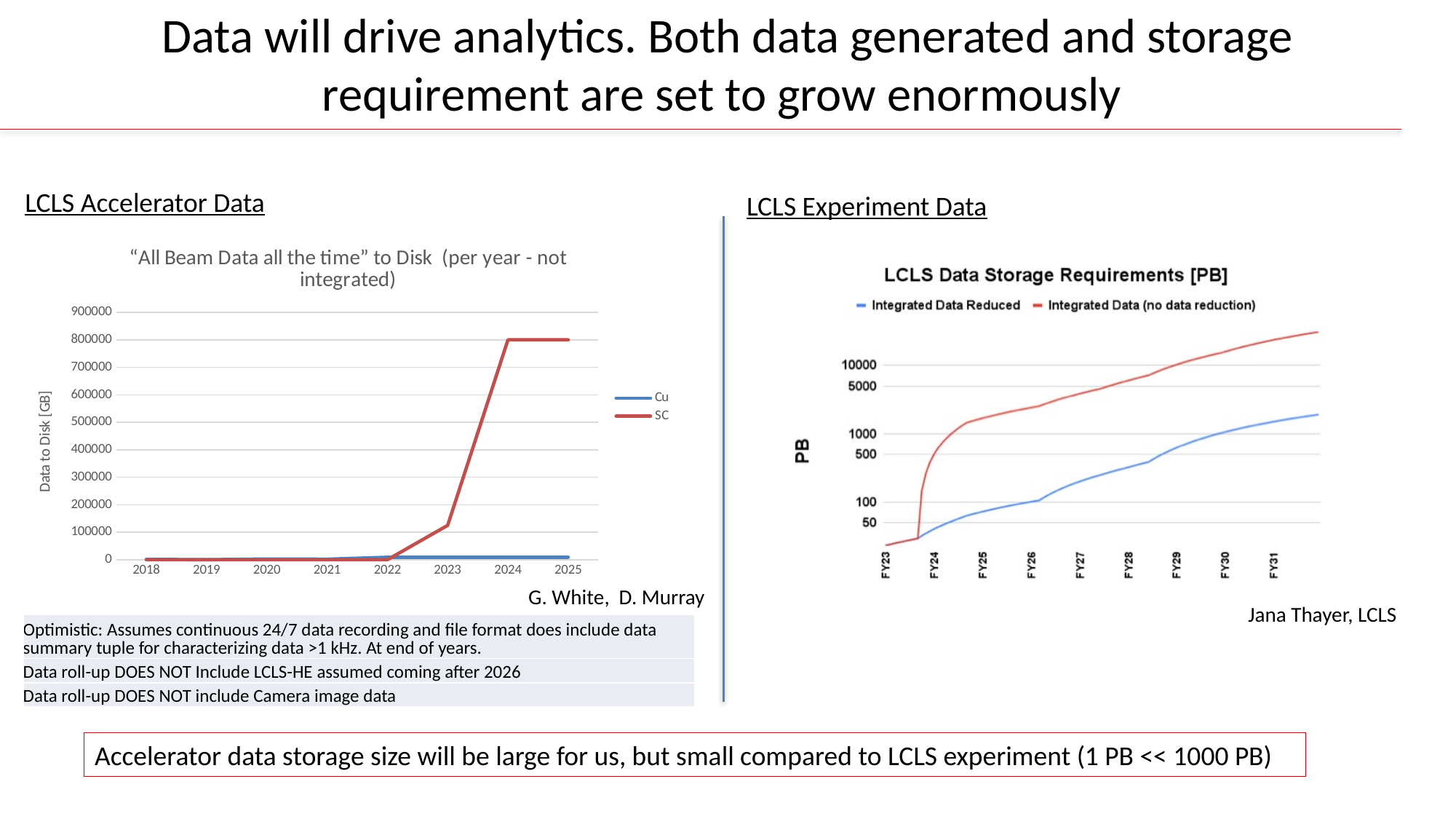
In the LCLS Data Storage Requirements [PB] chart on the right, is the Integrated Data (no data reduction) value at FY31 greater or less than 10000? greater In the "All Beam Data all the time" to Disk chart on the left, does the SC series rise or fall from 2022 to 2024? rise In the LCLS Data Storage Requirements [PB] chart on the right, how many fiscal years are shown on the x axis? 9 In the "All Beam Data all the time" to Disk chart on the left, what is the label of the y axis? Data to Disk [GB] In the "All Beam Data all the time" to Disk chart on the left, what kind of chart is shown? line chart In the "All Beam Data all the time" to Disk chart on the left, is the SC value in 2023 greater or less than 200000? less In the LCLS Data Storage Requirements [PB] chart on the right, how many series does the legend list? 2 In the LCLS Data Storage Requirements [PB] chart on the right, what kind of chart is shown? line chart In the "All Beam Data all the time" to Disk chart on the left, what is the SC value in 2024? 800000 In the "All Beam Data all the time" to Disk chart on the left, which series has the larger value in 2025, Cu or SC? SC In the "All Beam Data all the time" to Disk chart on the left, how many series does the legend list? 2 In the "All Beam Data all the time" to Disk chart on the left, how many years are shown on the x axis? 8